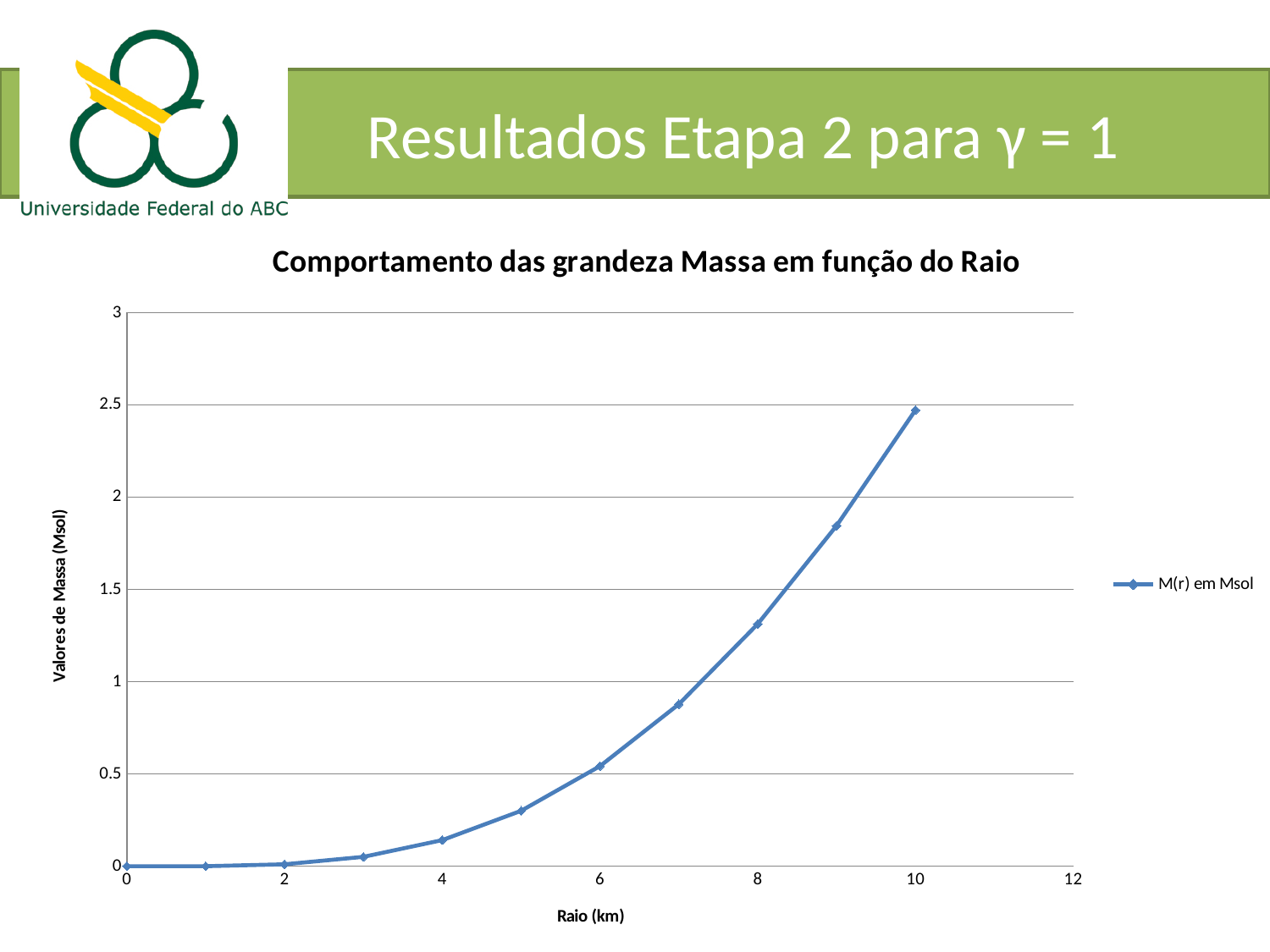
How many series does the legend list? 1 Which is larger, the value of M(r) at a radius of 9 km or at a radius of 7 km? 9 km Is the value of M(r) at a radius of 8 km greater or less than 1.5? less Do the values of M(r) rise or fall as the radius increases along the x axis? Rise What kind of chart is shown on the slide? Line chart Is the value of M(r) at a radius of 6 km greater or less than 1? less At which radius (km) is the mass value highest? 10 How many data points are plotted on the line? 11 What is the title of the chart? Comportamento das grandeza Massa em função do Raio Is the value of M(r) at a radius of 10 km greater or less than 2? greater What is the name of the series shown in the legend? M(r) em Msol